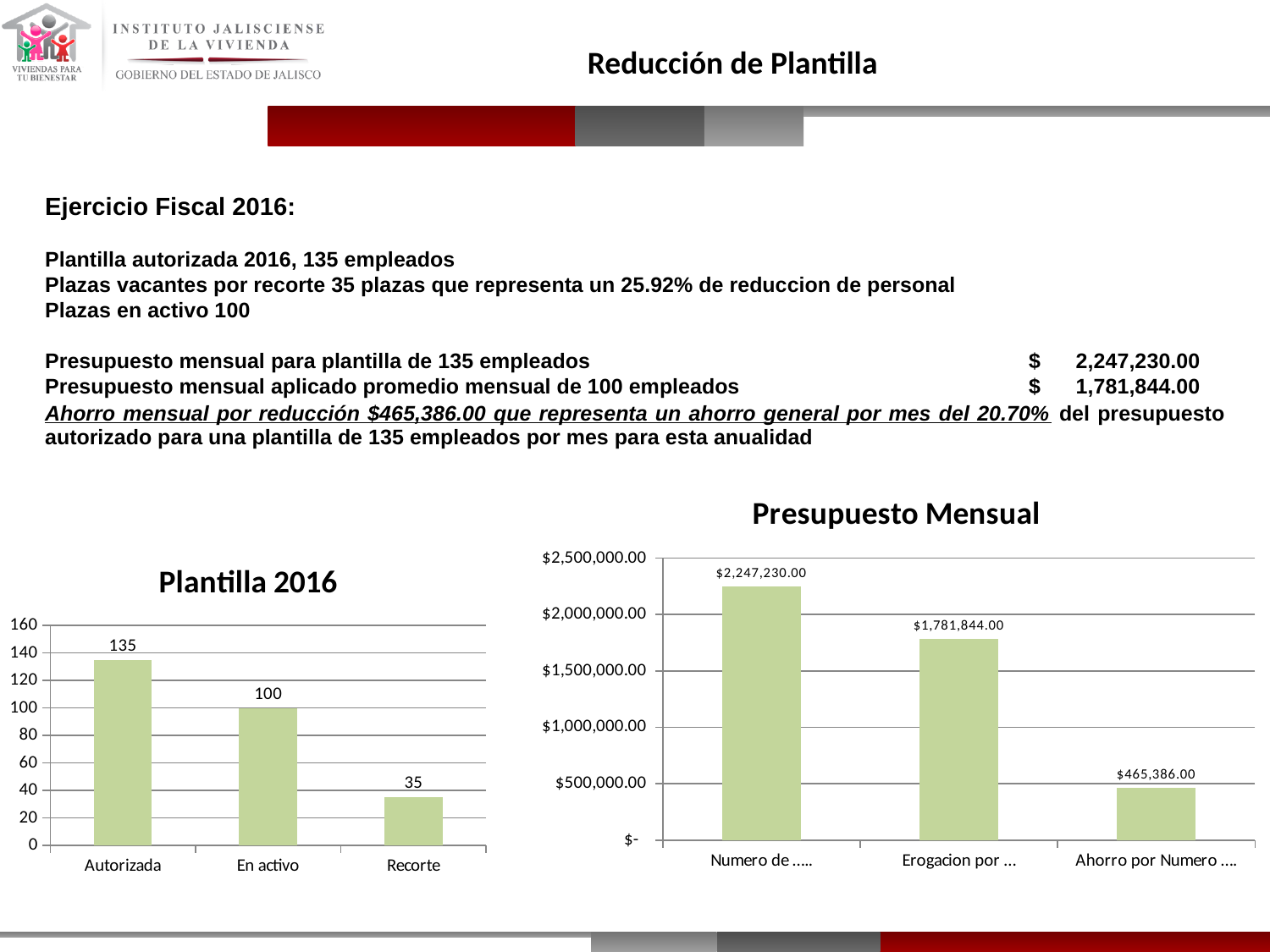
In the Plantilla 2016 chart, do the values rise or fall from left to right? fall In the Presupuesto Mensual chart, which bar is the highest? Numero de … (first bar) In the Plantilla 2016 chart, what is the value for Autorizada? 135 In the Presupuesto Mensual chart, what is the value of the third bar (Ahorro por Numero …)? $465,386.00 In the Presupuesto Mensual chart, is the value of the second bar (Erogacion por …) greater or less than $2,000,000.00? less In the Presupuesto Mensual chart, what is the difference between the first bar and the second bar (Erogacion por …)? $465,386.00 In the Plantilla 2016 chart, which category has the lowest value? Recorte In the Presupuesto Mensual chart, what is the value of the first bar (Numero de …)? $2,247,230.00 In the Plantilla 2016 chart, what is the value for Recorte? 35 In the Plantilla 2016 chart, how many categories are shown? 3 What type of chart is the Presupuesto Mensual chart? bar chart In the Plantilla 2016 chart, what is the difference between Autorizada and En activo? 35